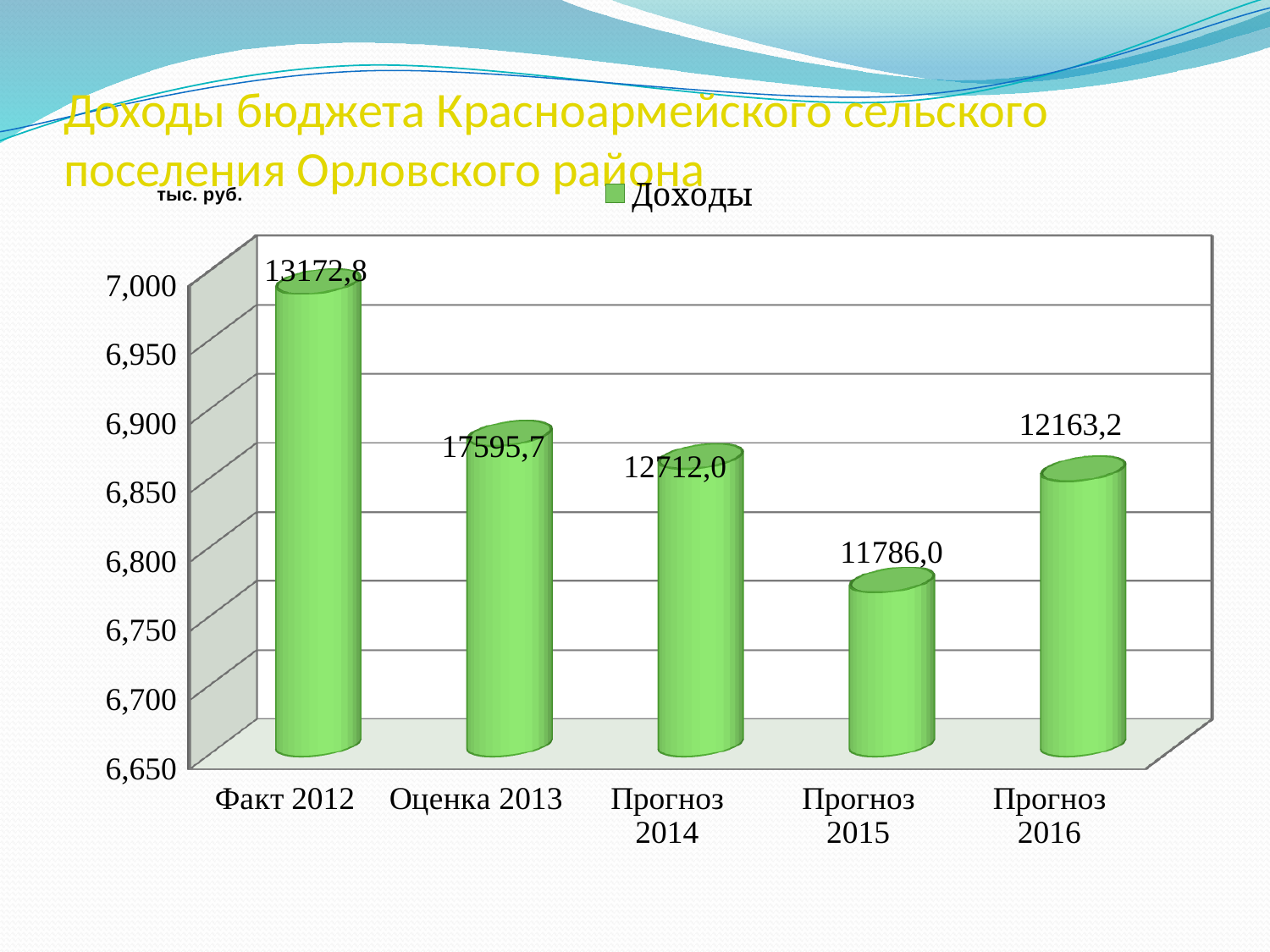
What unit is written above the vertical axis? тыс. руб. What kind of chart is shown on the slide? bar chart What is the difference between the data labels for Факт 2012 and Прогноз 2014? 460,8 What is the difference between the data labels for Прогноз 2016 and Прогноз 2015? 377,2 What is the data label for Оценка 2013? 17595,7 How many series does the legend list? 1 What is the data label for Факт 2012? 13172,8 What is the data label for Прогноз 2015? 11786,0 What series name is shown in the legend? Доходы What is the data label for Прогноз 2014? 12712,0 How many categories are shown on the x axis? 5 What is the data label for Прогноз 2016? 12163,2